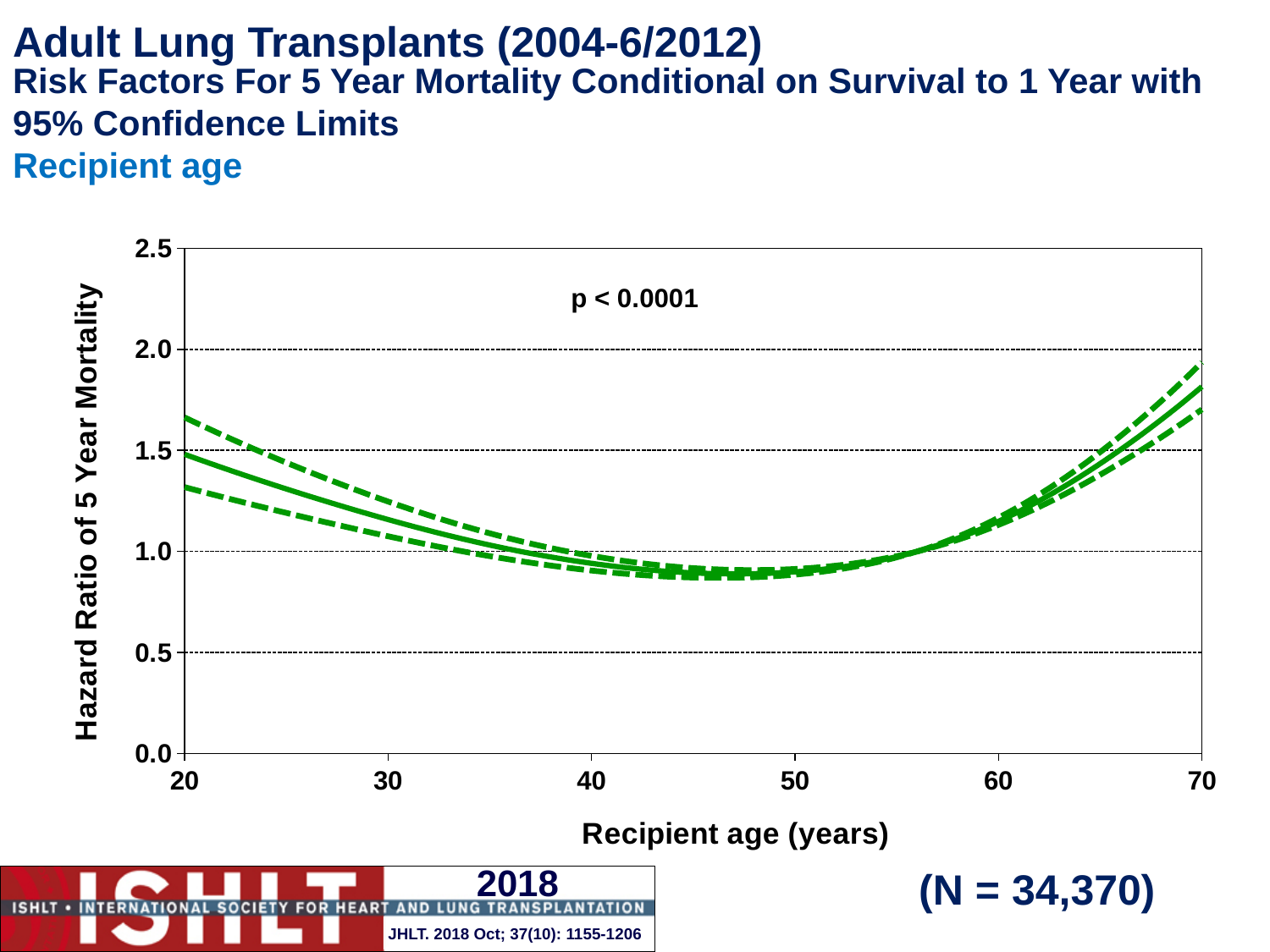
Which recipient age has the higher hazard ratio on the solid line, 40 or 60? 60 What is the label of the y axis? Hazard Ratio of 5 Year Mortality Which recipient age has the higher hazard ratio on the solid line, 20 or 70? 70 Does the hazard ratio rise or fall as recipient age increases from 55 to 70 years? rise Is the hazard ratio (solid line) at recipient age 70 greater or less than 1.5? greater Is the hazard ratio (solid line) at recipient age 45 greater or less than 1.0? less What kind of chart is shown on the slide? line chart What is the label of the x axis? Recipient age (years) How many labelled tick marks are on the x axis? 6 Is the hazard ratio (solid line) at recipient age 20 greater or less than 1.0? greater Does the hazard ratio rise or fall as recipient age increases from 20 to 45 years? fall